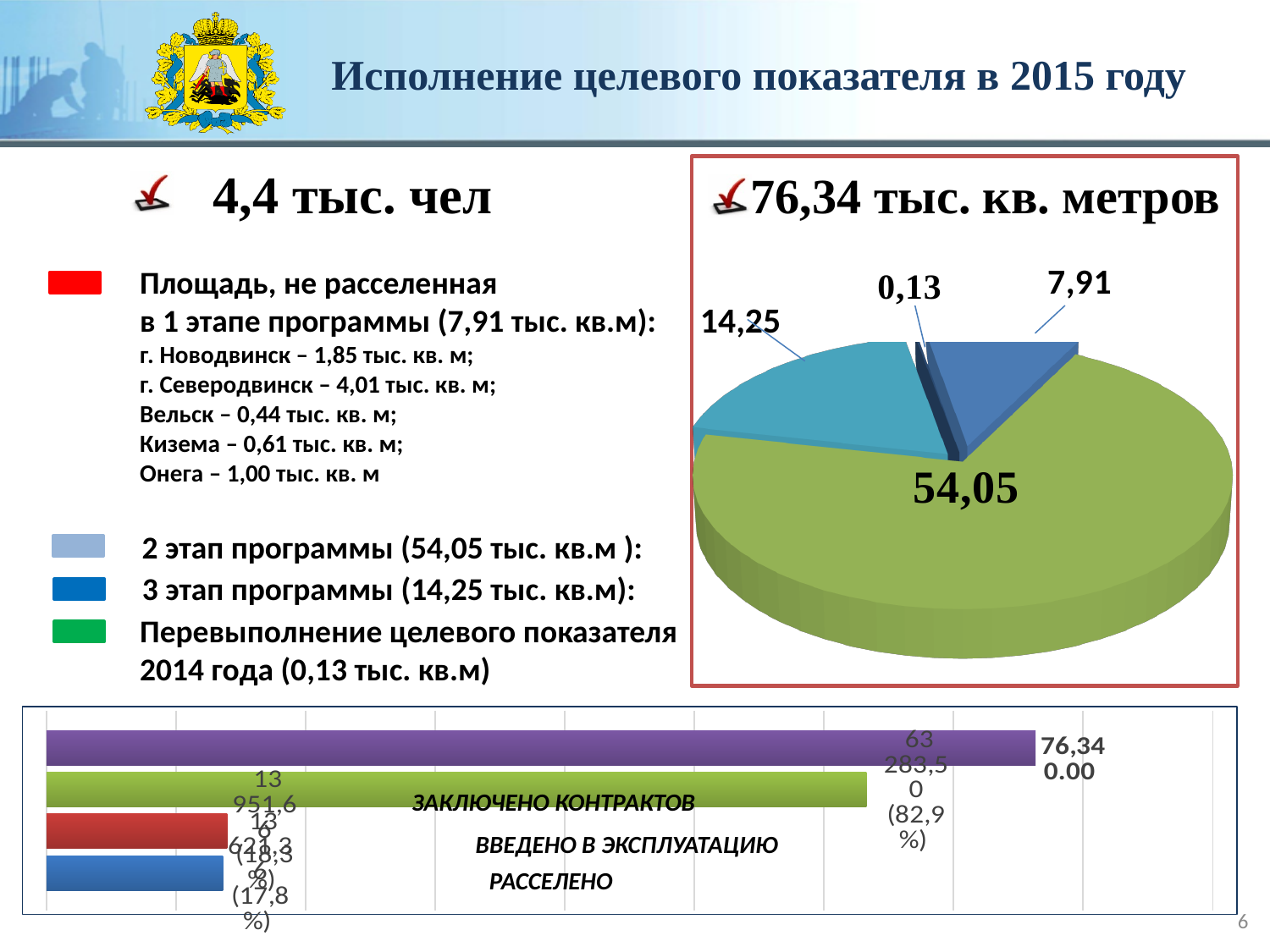
What is the title shown above the pie chart? 76,34 тыс. кв. метров On the pie chart titled '76,34 тыс. кв. метров', which is larger: the slice labelled 7,91 or the slice labelled 14,25? 14,25 On the pie chart titled '76,34 тыс. кв. метров', what is the difference between the slice labelled 14,25 and the slice labelled 7,91? 6,34 On the bar chart at the bottom of the slide, what is the value labelled on the longest (purple) bar? 76,340.00 What kind of chart is shown at the bottom of the slide? Bar chart On the pie chart titled '76,34 тыс. кв. метров', how many slices are there? 4 On the pie chart titled '76,34 тыс. кв. метров', what is the difference between the slice labelled 54,05 and the slice labelled 14,25? 39,80 On the bar chart at the bottom of the slide, how many bars are there? 4 On the bar chart at the bottom of the slide, which bar is the shortest: the purple, green, red or blue one? Blue On the pie chart titled '76,34 тыс. кв. метров', what is the value of the smallest slice? 0,13 What kind of chart is shown in the upper right of the slide? Pie chart On the pie chart titled '76,34 тыс. кв. метров', what is the value of the largest slice? 54,05